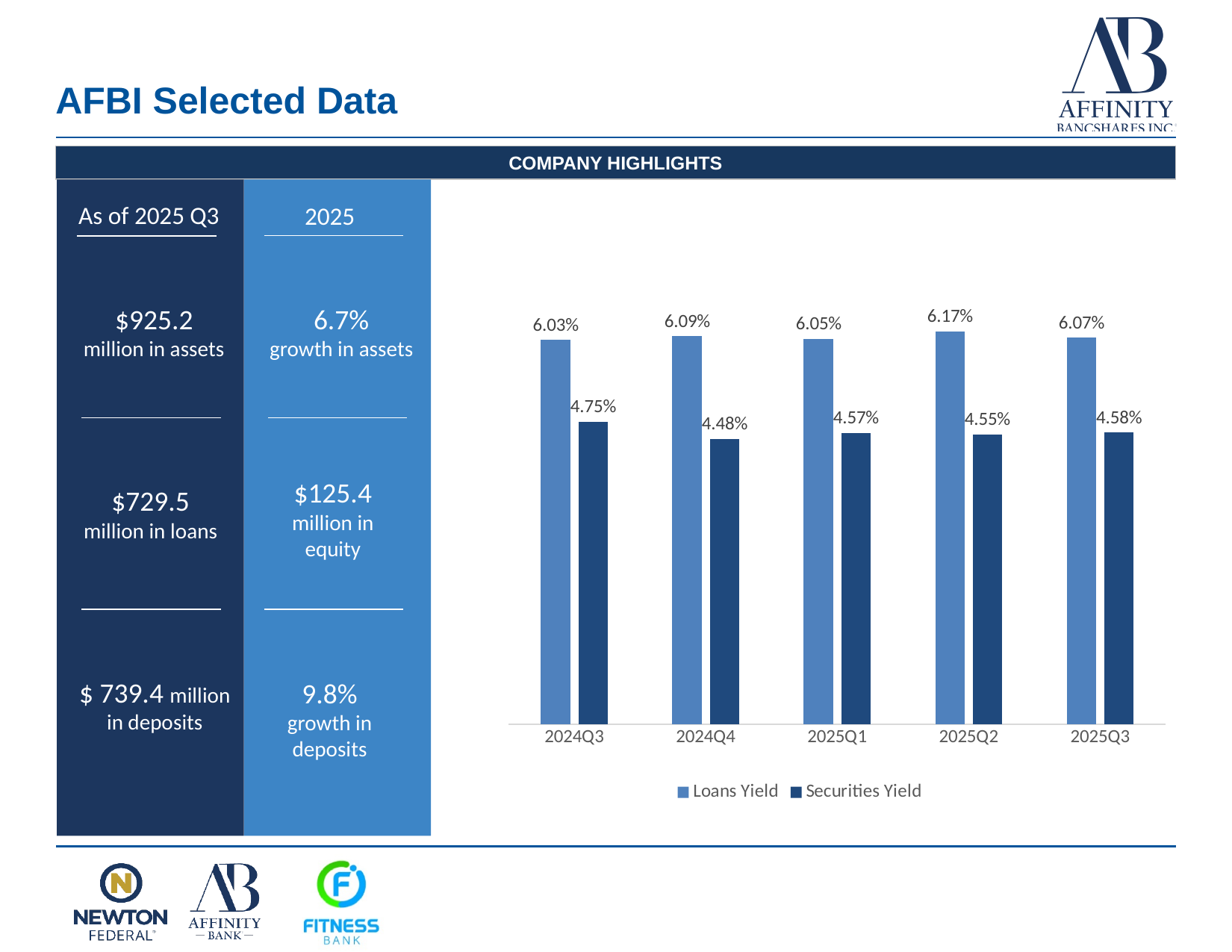
What is the Securities Yield for 2025Q1? 4.57% Which is larger, the Securities Yield in 2024Q3 or in 2025Q3? 2024Q3 What are the two series named in the chart legend? Loans Yield and Securities Yield What is the difference between the Loans Yield and the Securities Yield in 2025Q2? 1.62% How many series does the chart legend list? 2 How many quarters are shown on the x axis of the chart? 5 Did the Securities Yield rise or fall from 2024Q3 to 2024Q4? Fall What is the Loans Yield for 2024Q3? 6.03% What is the Loans Yield for 2025Q3? 6.07% Which quarter has the lowest Securities Yield? 2024Q4 Which quarter has the highest Loans Yield? 2025Q2 What kind of chart is shown on the slide? Bar chart